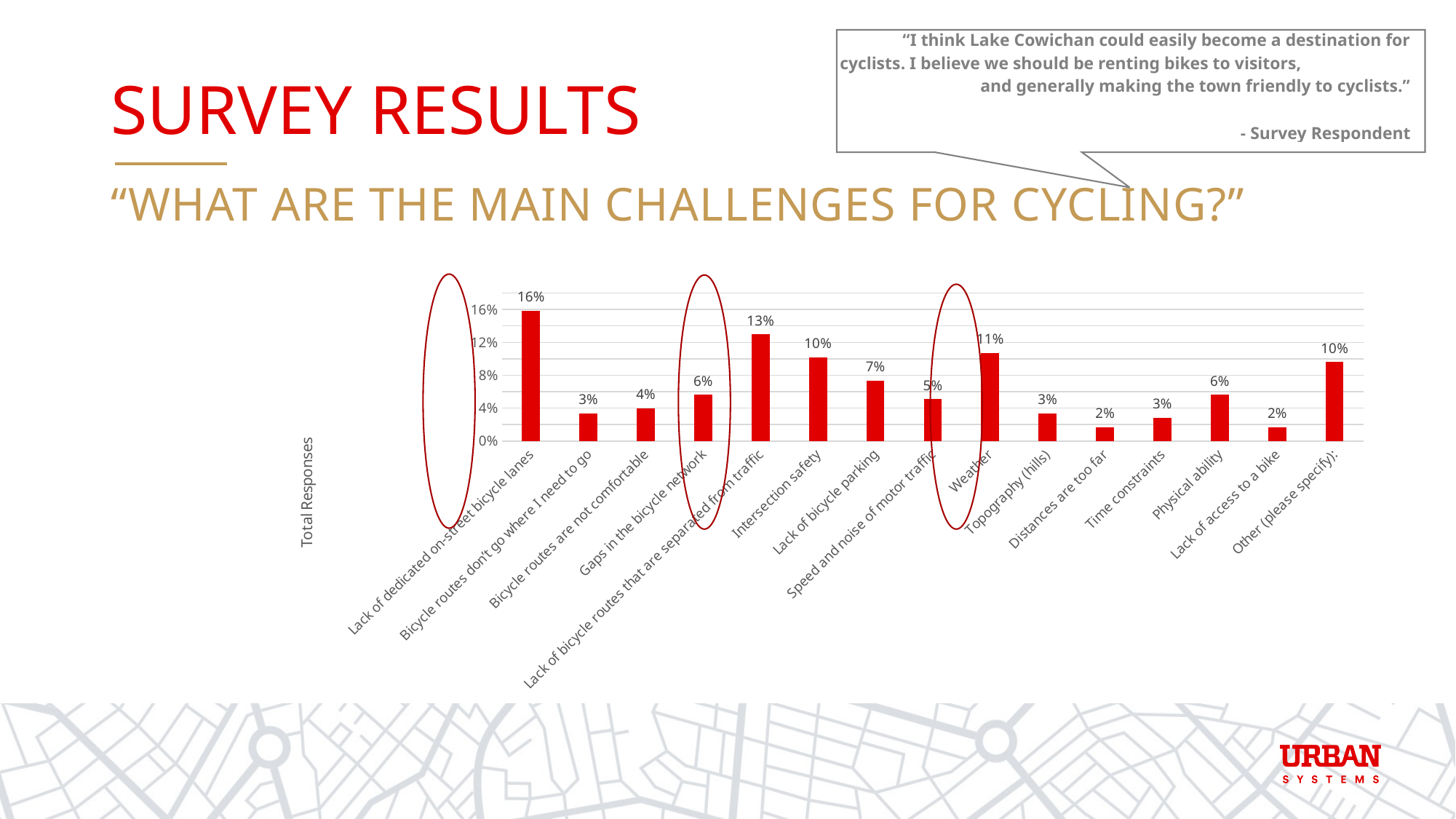
Which challenge has the highest percentage of responses? Lack of dedicated on-street bicycle lanes What is the value for "Gaps in the bicycle network"? 6% What is the label on the vertical axis of the chart? Total Responses What percentage is shown for "Lack of bicycle routes that are separated from traffic"? 13% Is the value for "Speed and noise of motor traffic" greater or less than 8%? less What percentage of responses cited "Lack of dedicated on-street bicycle lanes" as a main challenge for cycling? 16% How many challenge categories are plotted on the chart? 15 What is the difference between the values for "Lack of dedicated on-street bicycle lanes" and "Distances are too far"? 14% Which has a larger value, "Weather" or "Other (please specify):"? Weather What is the difference between the values for "Intersection safety" and "Lack of bicycle parking"? 3% What kind of chart is used to show the survey results? Bar chart What is the value shown for "Weather"? 11%